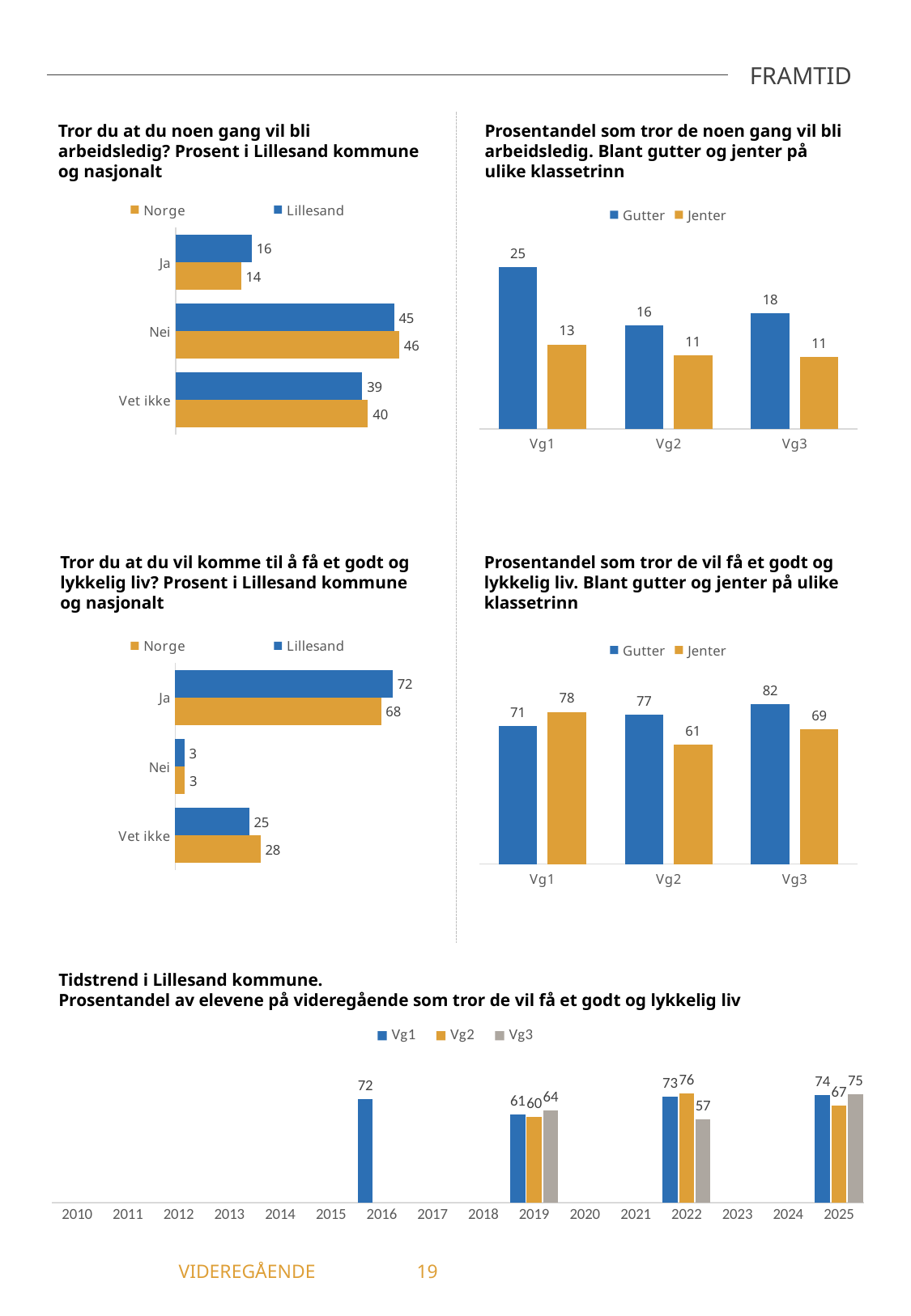
In the top-right chart 'Prosentandel som tror de noen gang vil bli arbeidsledig', what is the value for Jenter in Vg2? 11 In the top-right chart 'Prosentandel som tror de noen gang vil bli arbeidsledig', which class level has the highest value for Gutter? Vg1 What type of chart is the bottom chart 'Tidstrend i Lillesand kommune'? Bar chart In the middle-right chart 'Prosentandel som tror de vil få et godt og lykkelig liv', what is the difference between Gutter and Jenter in Vg2? 16 In the top-left chart 'Tror du at du noen gang vil bli arbeidsledig?', what is the difference between the Norge and Lillesand values for 'Ja'? 2 In the bottom chart 'Tidstrend i Lillesand kommune', how many series does the legend list? 3 In the middle-right chart 'Prosentandel som tror de vil få et godt og lykkelig liv', which class level has the lowest value for Jenter? Vg2 In the bottom chart 'Tidstrend i Lillesand kommune', what is the value for Vg3 in 2022? 57 In the middle-left chart 'Tror du at du vil komme til å få et godt og lykkelig liv?', what is the value for Norge for 'Vet ikke'? 28 In the top-left chart 'Tror du at du noen gang vil bli arbeidsledig?', what is the value for Lillesand for 'Nei'? 45 In the middle-left chart 'Tror du at du vil komme til å få et godt og lykkelig liv?', which is larger for 'Ja': Norge or Lillesand? Lillesand In the middle-right chart 'Prosentandel som tror de vil få et godt og lykkelig liv', what is the value for Gutter in Vg3? 82